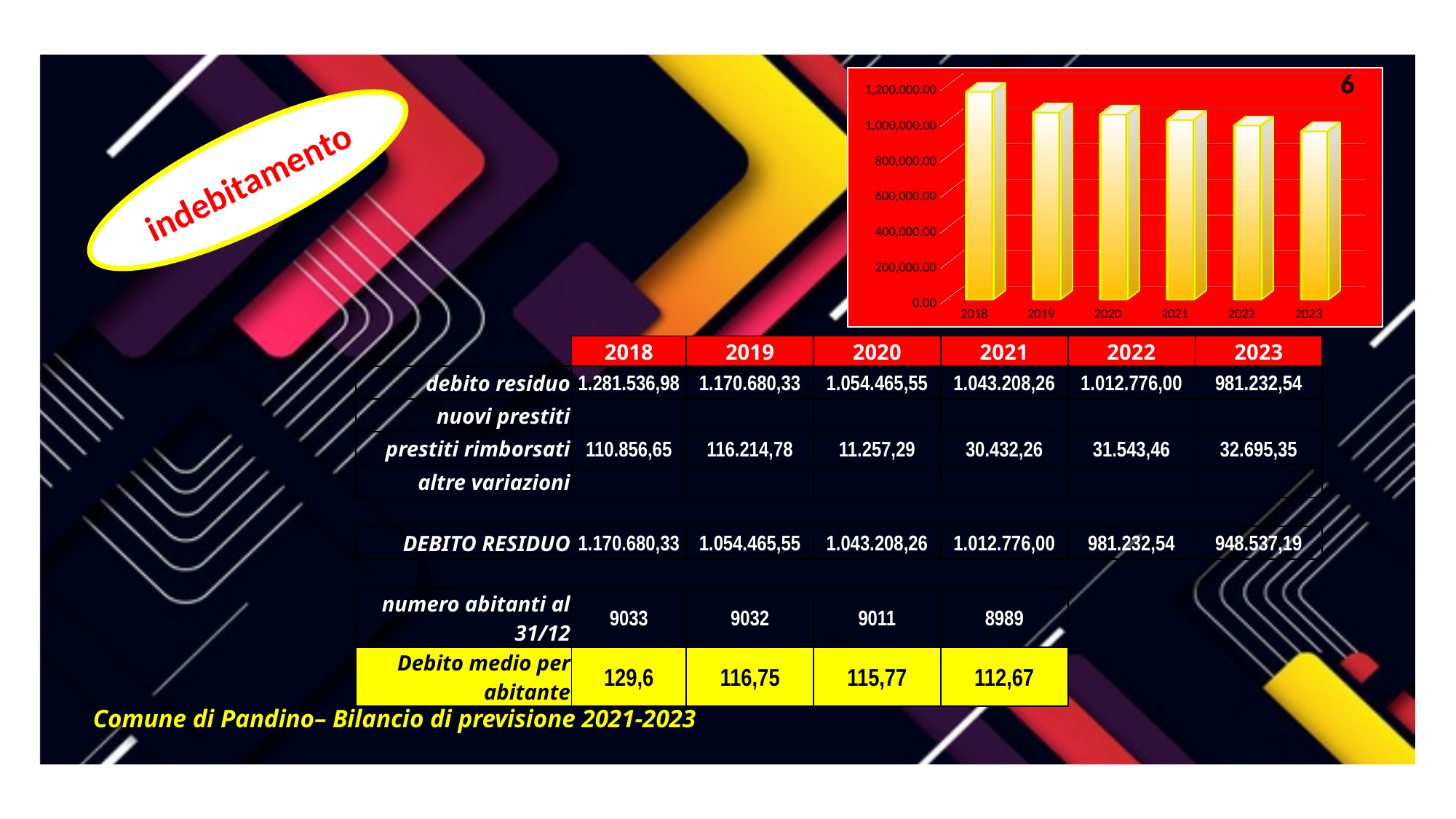
Which bar is taller, 2019 or 2023? 2019 How many bars (years) does the chart show? 6 Which year has the tallest bar in the chart? 2018 What is the first year shown on the x axis of the chart? 2018 Is the value for 2021 greater or less than 800,000.00? greater Which year has the shortest bar in the chart? 2023 What kind of chart is shown on the slide? bar chart Is the value for 2023 greater or less than 1,000,000.00? less Which bar is taller, 2018 or 2019? 2018 Is the value for 2018 greater or less than 1,000,000.00? greater Do the bar values rise or fall from 2018 to 2023? fall